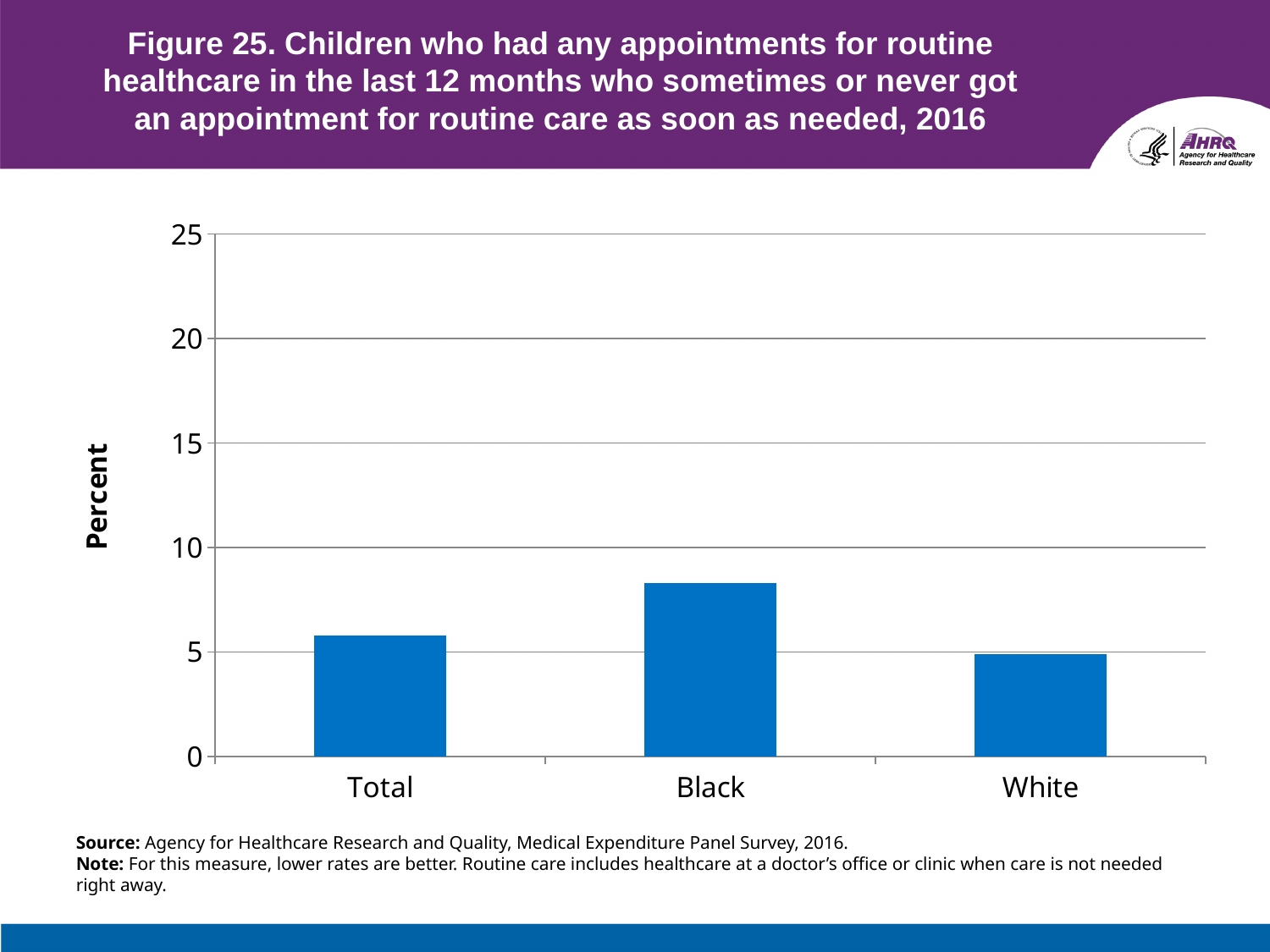
Is the value for White greater or less than 10? less Is the value for Black greater or less than 5? greater Is the value for Total greater or less than 5? greater What kind of chart is shown on the slide? bar chart What is the label on the vertical axis of the chart? Percent How many categories are shown on the x axis of the chart? 3 What is the highest value shown on the vertical axis of the chart? 25 Which category has the highest value in the chart? Black Which is larger, the value for Total or the value for White? Total Which category has the lowest value in the chart? White Which is larger, the value for Black or the value for Total? Black